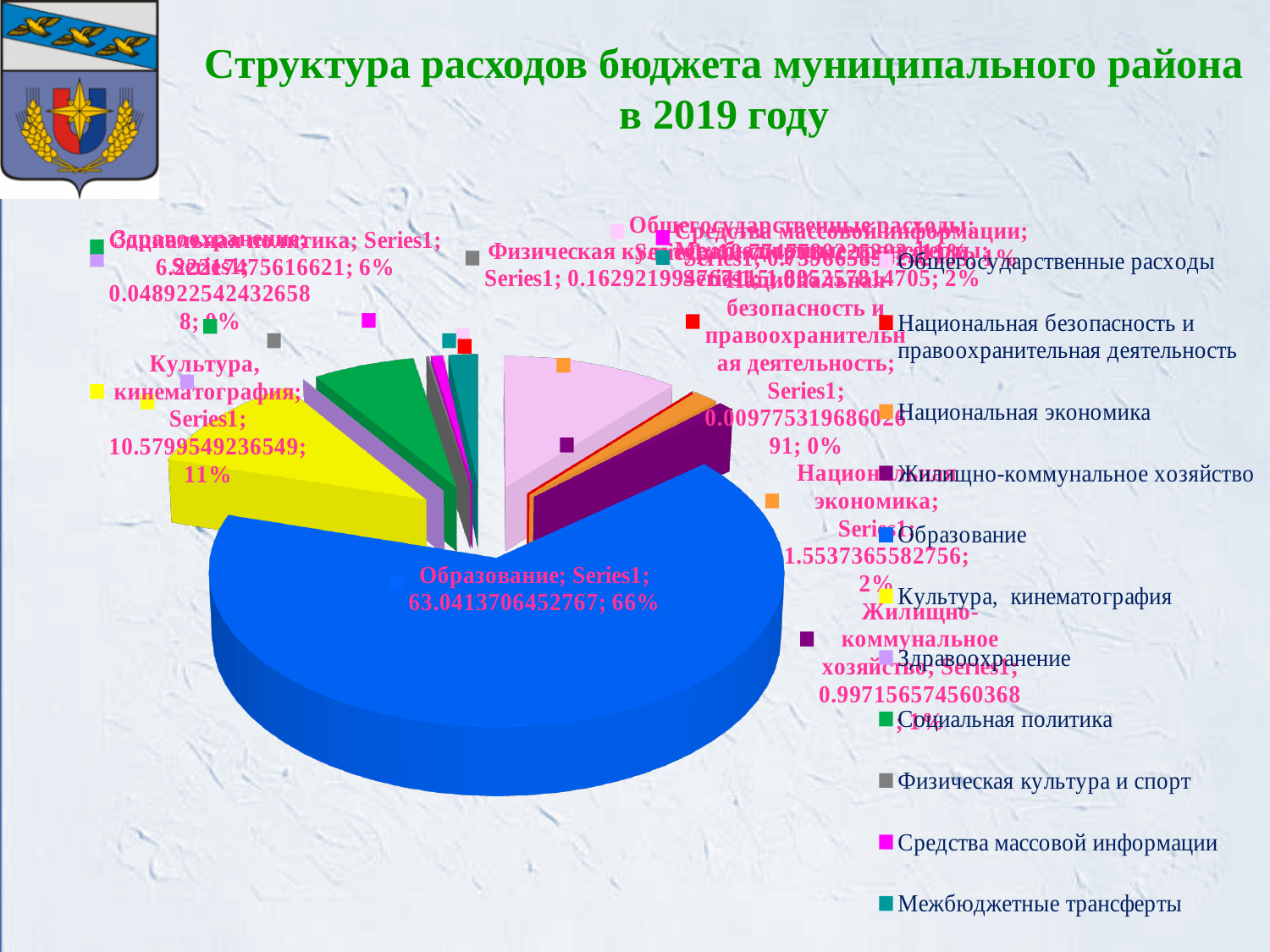
What share of the pie does Образование take? 66% How many categories does the legend list? 11 What is the value shown in the data label for Образование? 63.0413706452767 What share of the pie does Национальная экономика take? 2% What share of the pie does Жилищно-коммунальное хозяйство take? 1% Which is larger, the share for Образование or the share for Культура, кинематография? Образование Which category has the largest share of the pie? Образование What is the difference in percentage points between the share for Образование and the share for Культура, кинематография? 55 What kind of chart is shown on the slide? pie chart What is the value shown in the data label for Культура, кинематография? 10.5799549236549 What is the title of the chart? Структура расходов бюджета муниципального района в 2019 году